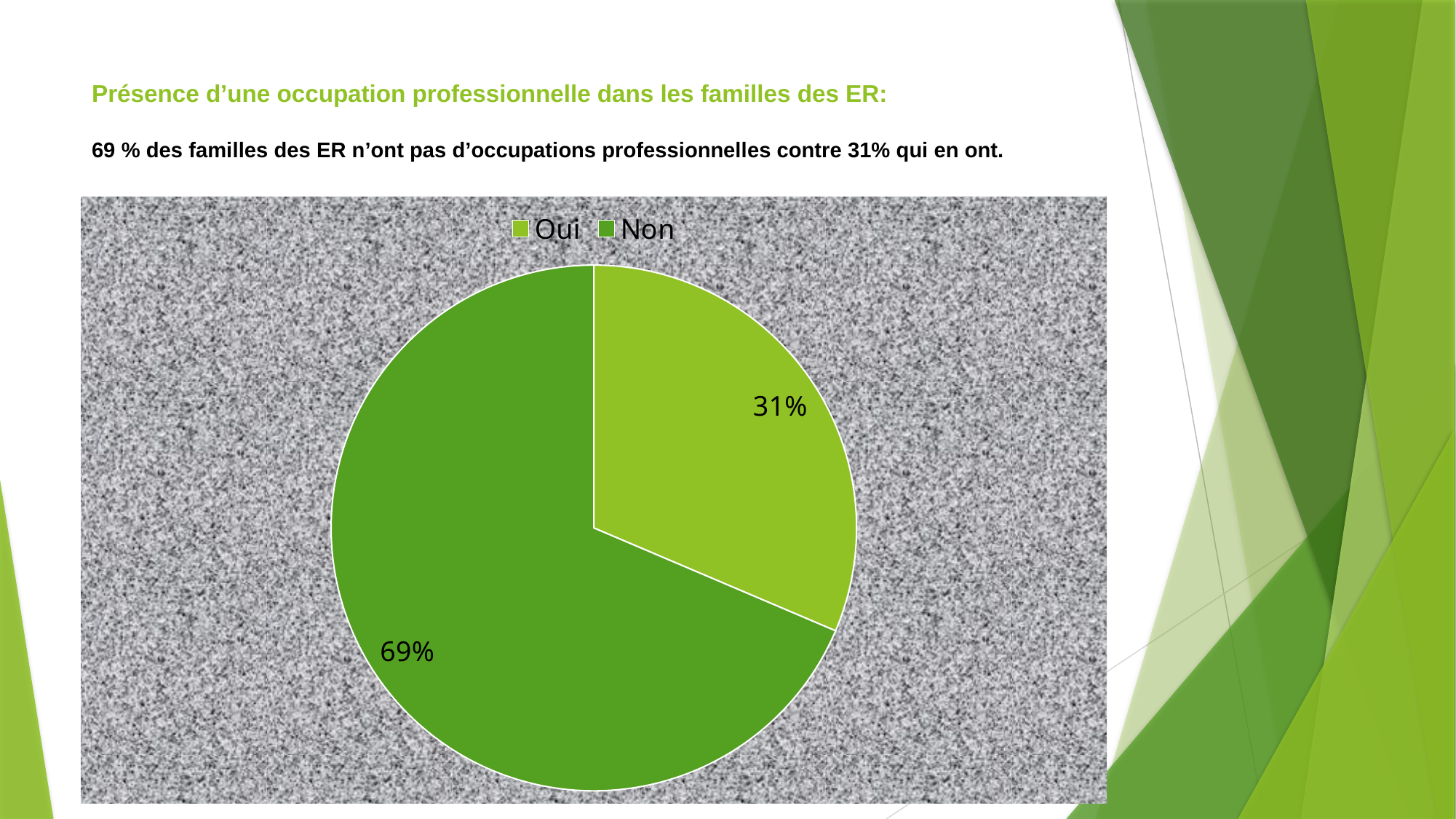
Which category has the largest slice? Non What is the value for the Oui slice? 31% Which is larger, the Oui slice or the Non slice? Non What is the difference between the Non and Oui values? 38% Which category has the smallest slice? Oui What is the value for the Non slice? 69% Which slice is shown in the darker green colour? Non What are the two legend entries of the chart? Oui and Non What kind of chart is shown on the slide? pie chart How many entries does the legend list? 2 How many slices does the pie chart have? 2 What share of the pie does the Non slice represent? 69%